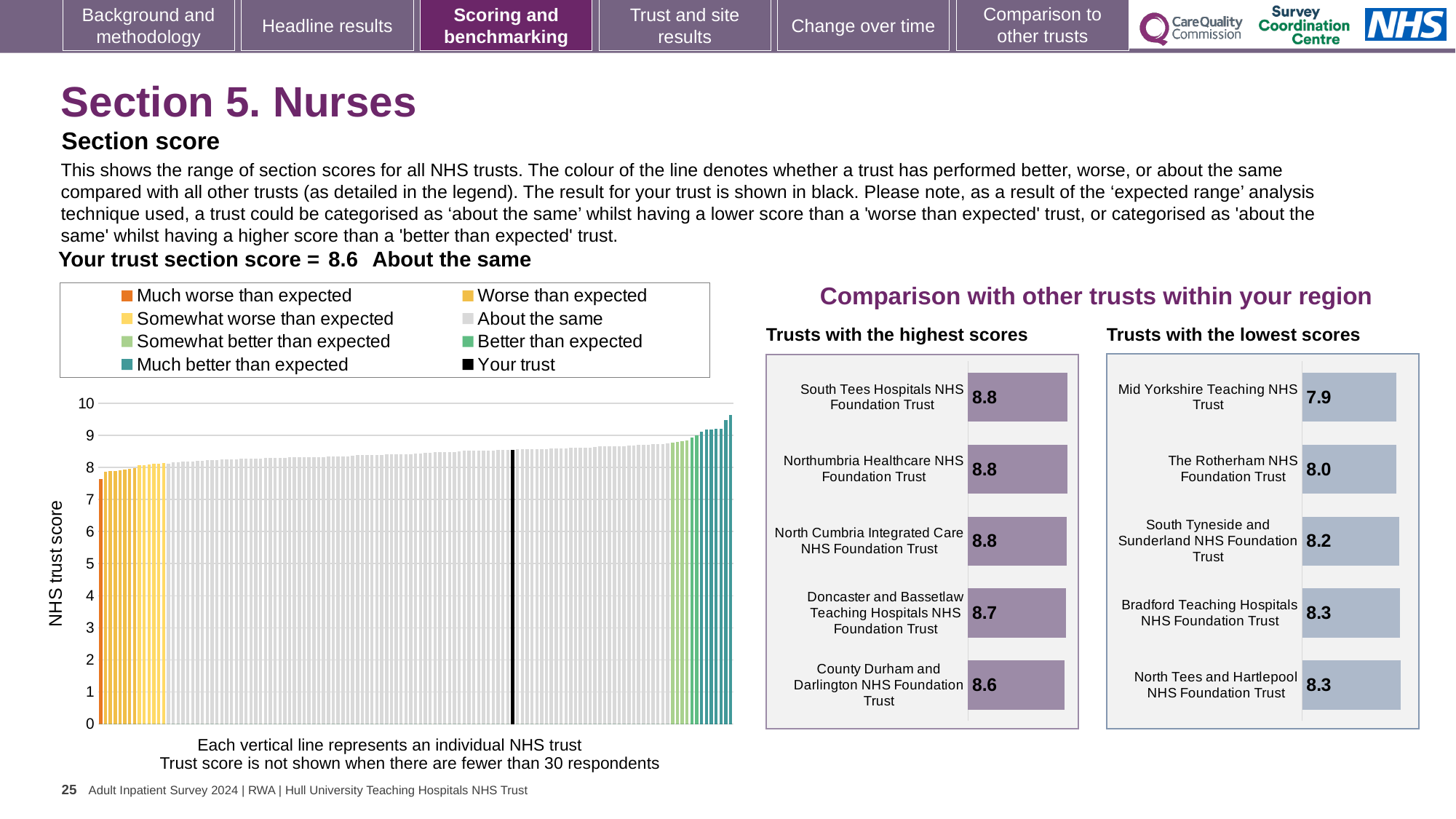
What kind of chart is the large chart on the left showing the range of section scores for all NHS trusts? Bar chart In the 'Trusts with the lowest scores' chart, which has the larger score: The Rotherham NHS Foundation Trust or South Tyneside and Sunderland NHS Foundation Trust? South Tyneside and Sunderland NHS Foundation Trust How many entries does the legend of the large chart on the left list? 8 In the 'Trusts with the lowest scores' chart, what is the difference between the scores of Bradford Teaching Hospitals NHS Foundation Trust and Mid Yorkshire Teaching NHS Trust? 0.4 In the 'Trusts with the lowest scores' chart, what is the score for Mid Yorkshire Teaching NHS Trust? 7.9 In the 'Trusts with the lowest scores' chart, what is the score for South Tyneside and Sunderland NHS Foundation Trust? 8.2 In the 'Trusts with the highest scores' chart, what is the difference between the scores of South Tees Hospitals NHS Foundation Trust and County Durham and Darlington NHS Foundation Trust? 0.2 In the 'Trusts with the highest scores' chart, what is the score for Doncaster and Bassetlaw Teaching Hospitals NHS Foundation Trust? 8.7 How many trusts are shown in the 'Trusts with the highest scores' chart? 5 In the 'Trusts with the highest scores' chart, which trust has the lowest score? County Durham and Darlington NHS Foundation Trust In the 'Trusts with the highest scores' chart, what is the score for South Tees Hospitals NHS Foundation Trust? 8.8 In the 'Trusts with the lowest scores' chart, which trust has the lowest score? Mid Yorkshire Teaching NHS Trust